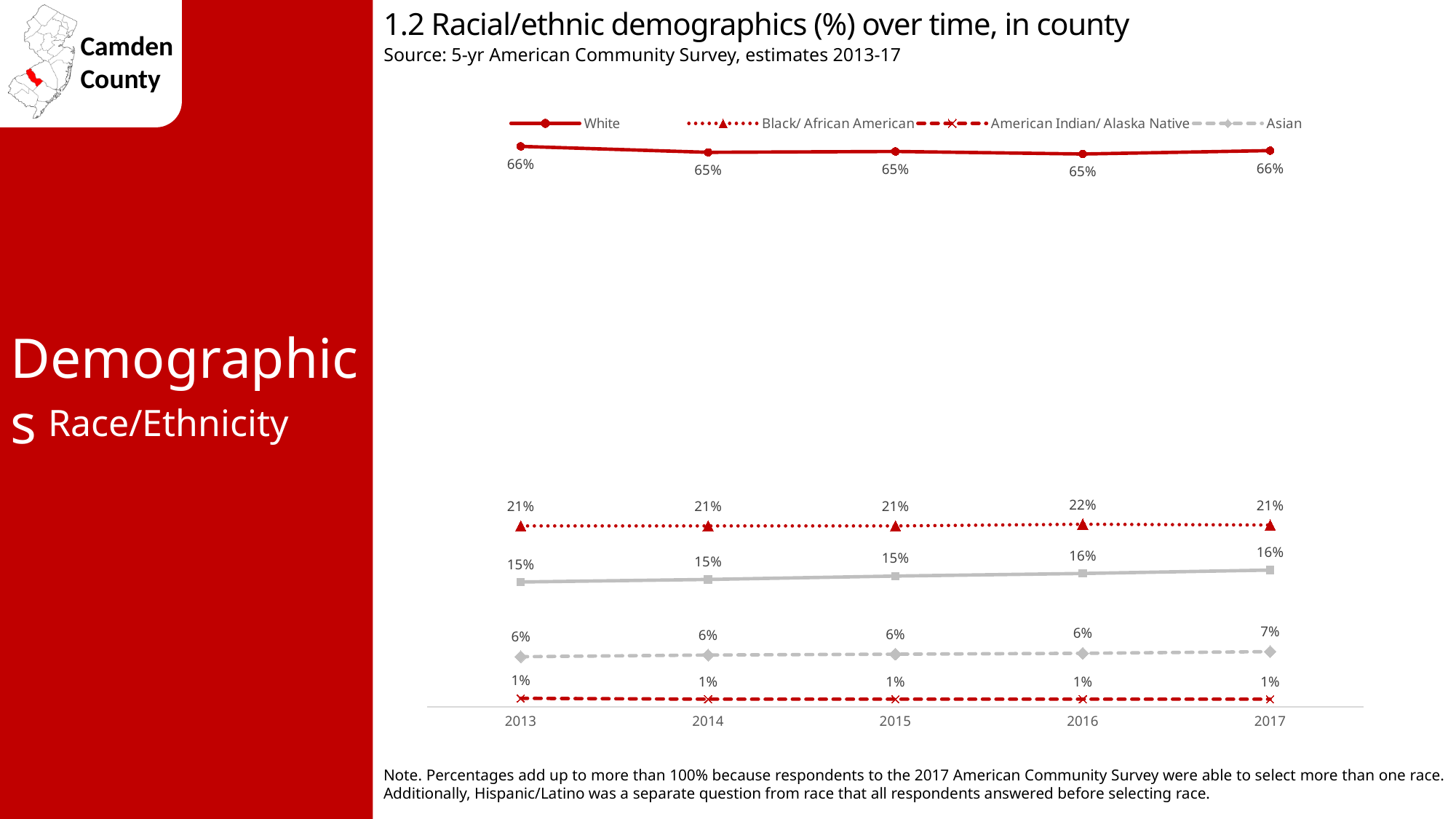
Does the value for Asian rise or fall from 2013 to 2017? rises How many years are shown on the x axis? 5 What is the difference between the White and Black/ African American values in 2017? 45% Which is larger in 2017, the value for Asian or the value for American Indian/ Alaska Native? Asian What is the value for American Indian/ Alaska Native in 2015? 1% What is the value for Black/ African American in 2016? 22% What kind of chart is shown on the slide? line chart What is the value for White in 2013? 66% Which series has the lowest value in 2014? American Indian/ Alaska Native Which series has the highest value in 2017? White How many series does the legend list? 4 What is the value for Asian in 2017? 7%